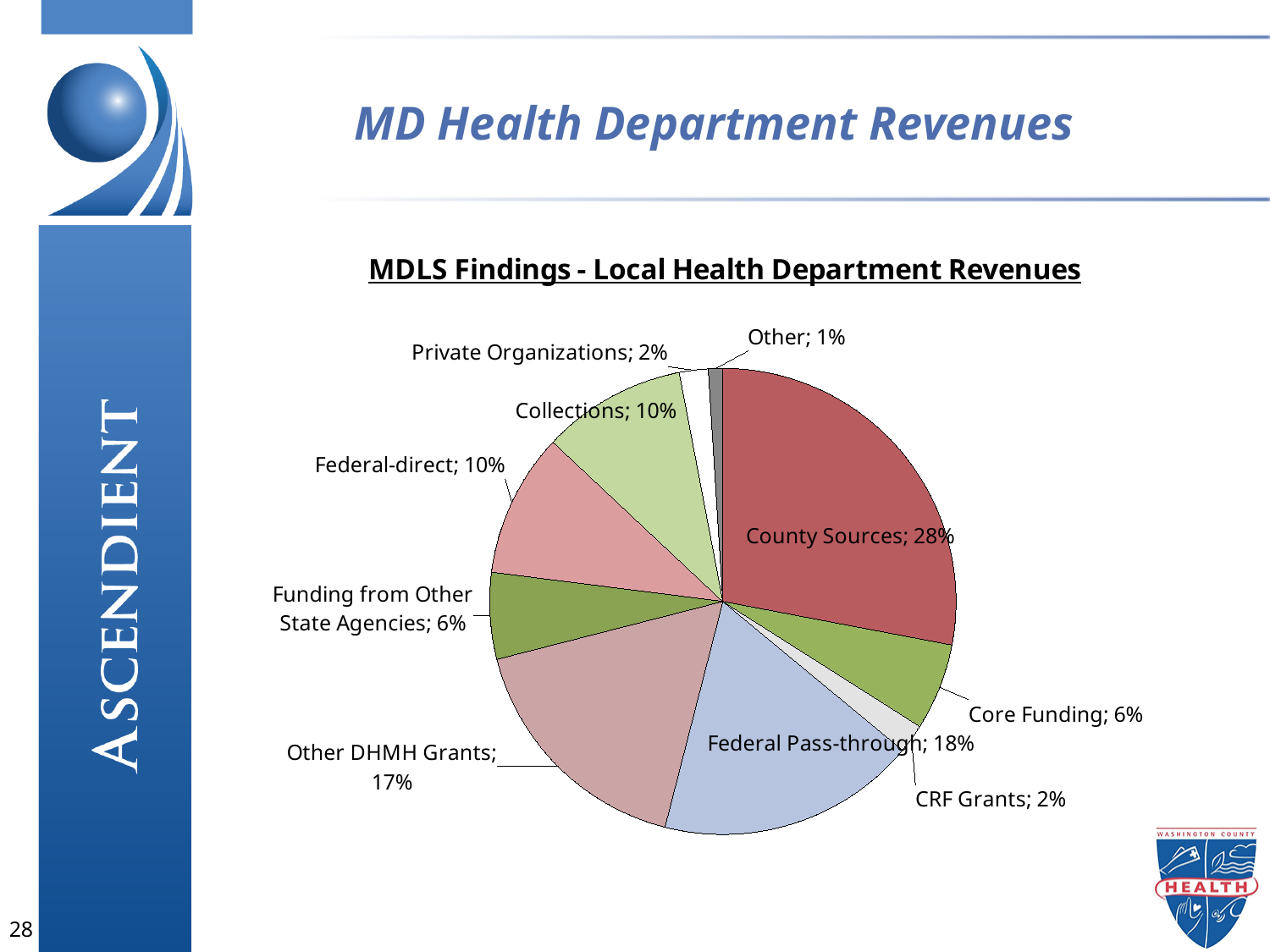
Which revenue source has the smallest share of the pie? Other What is the difference in percentage points between County Sources and Federal Pass-through? 10 Which revenue source has the largest share of the pie? County Sources What is the title of the chart? MDLS Findings - Local Health Department Revenues Which is larger, Other DHMH Grants or Collections? Other DHMH Grants How many slices does the pie chart have? 10 What type of chart is shown on the slide? Pie chart What share of revenues comes from County Sources? 28% What percentage is shown for Funding from Other State Agencies? 6% What is the combined share of Collections and Federal-direct? 20% What share of revenues is Other DHMH Grants? 17% What percentage of revenues is Federal Pass-through? 18%